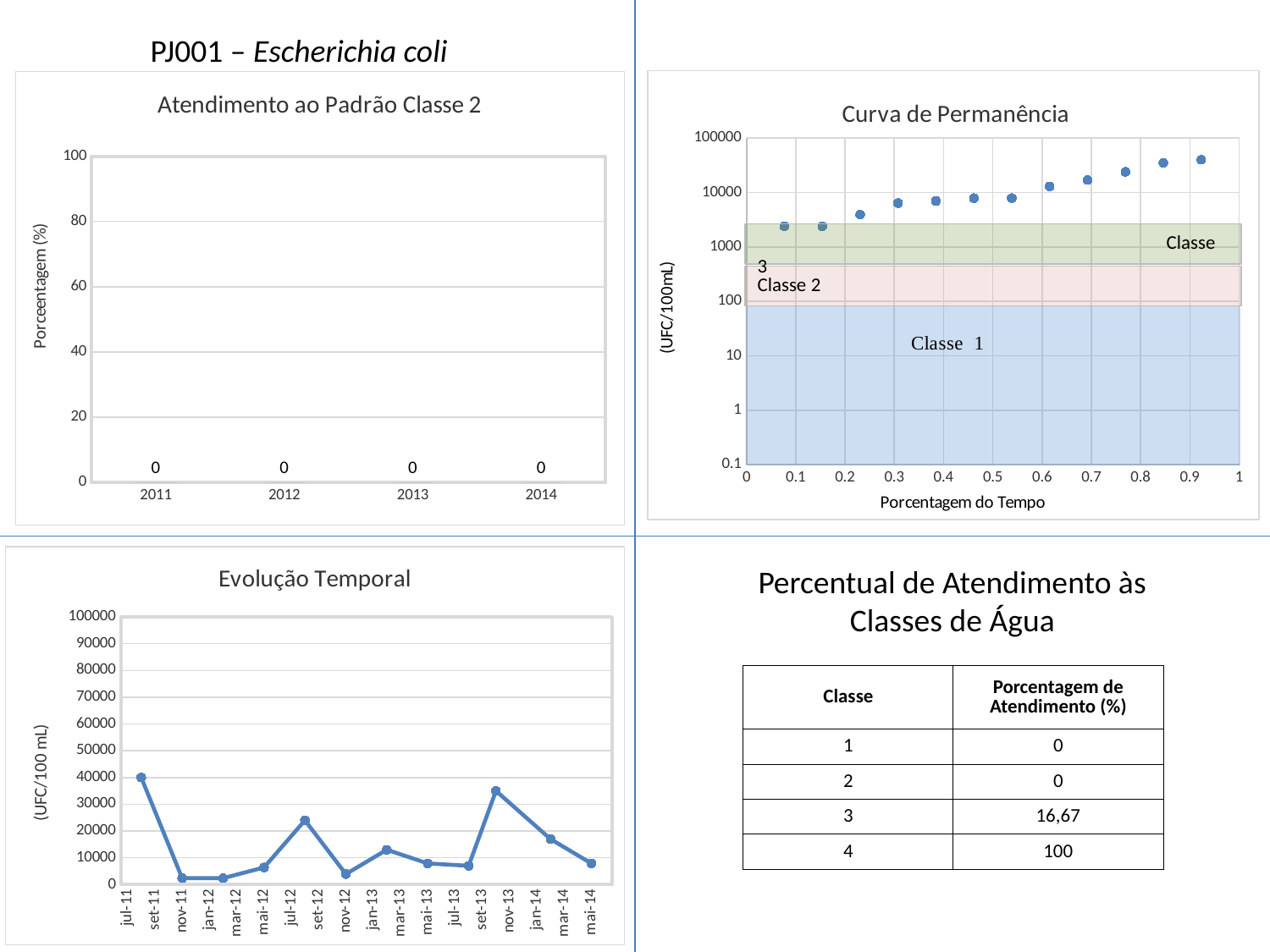
In the 'Curva de Permanência' chart, what is the x-axis title? Porcentagem do Tempo In the 'Atendimento ao Padrão Classe 2' chart, what is the value for 2012? 0 In the 'Evolução Temporal' chart, is the value for nov-11 greater or less than 10000? less What kind of chart is 'Curva de Permanência'? scatter chart In the 'Curva de Permanência' chart, do the values rise or fall as the percentage of time increases? rise In the 'Atendimento ao Padrão Classe 2' chart, how many years are shown on the x axis? 4 In the 'Atendimento ao Padrão Classe 2' chart, what is the value for 2014? 0 In the 'Evolução Temporal' chart, which date has the highest value? jul-11 In the 'Curva de Permanência' chart, is the value of the rightmost point (near 0.92) greater or less than 10000? greater What kind of chart is 'Evolução Temporal'? line chart In the 'Evolução Temporal' chart, which is larger, the value for jul-12 or the value for jan-13? jul-12 In the 'Evolução Temporal' chart, what is the y-axis label? (UFC/100 mL)